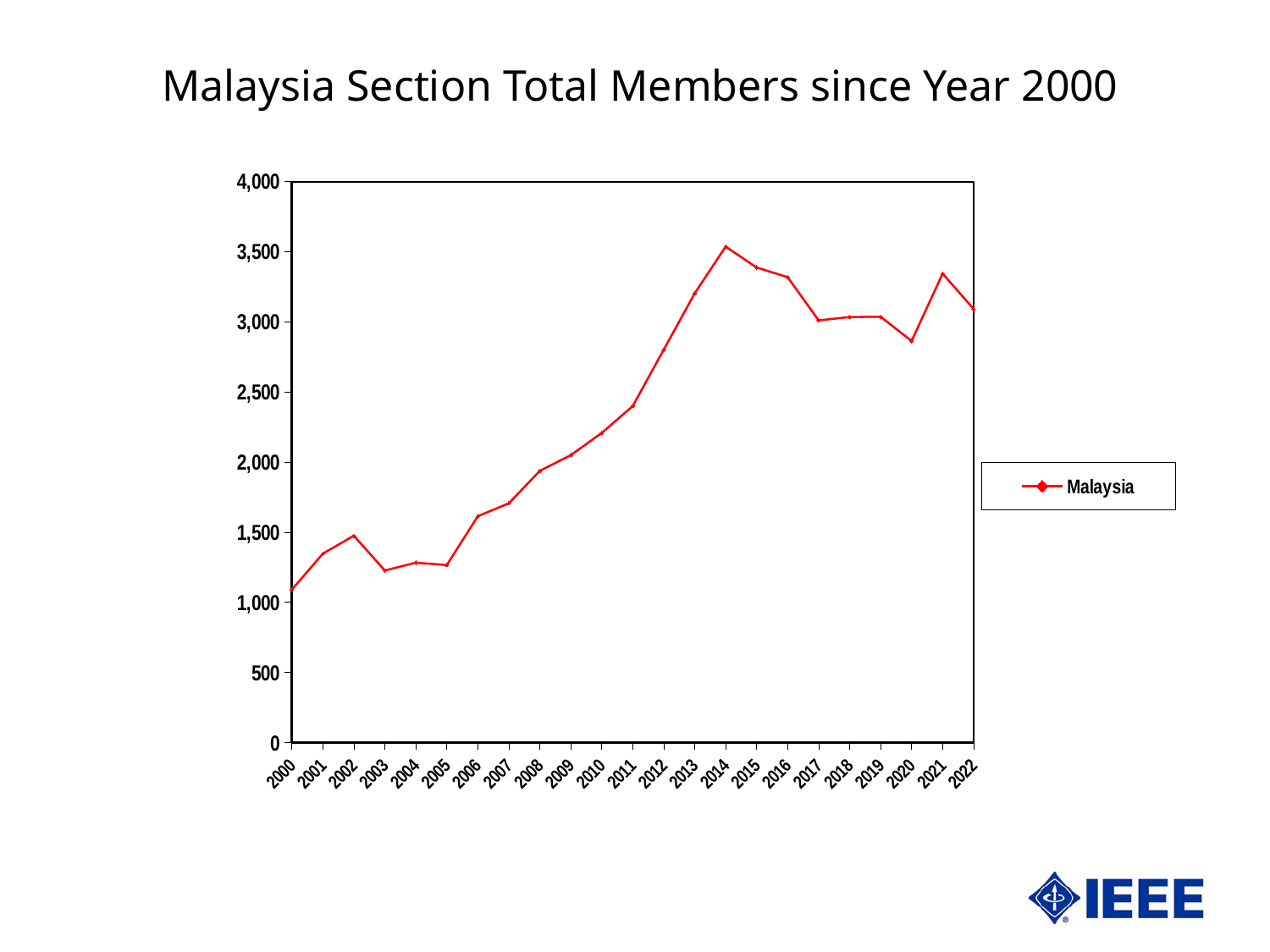
Do the values generally rise or fall from 2005 to 2014? rise In which year is the number of members highest? 2014 How many years are plotted along the x axis? 23 What is the name of the series shown in the legend? Malaysia Is the value for 2000 greater or less than 1,500? less In which year is the number of members lowest? 2000 What is the title of the chart? Malaysia Section Total Members since Year 2000 Which year has more members, 2021 or 2020? 2021 What kind of chart is shown on the slide? line chart Is the value for 2020 greater or less than 3,000? less How many series does the legend list? 1